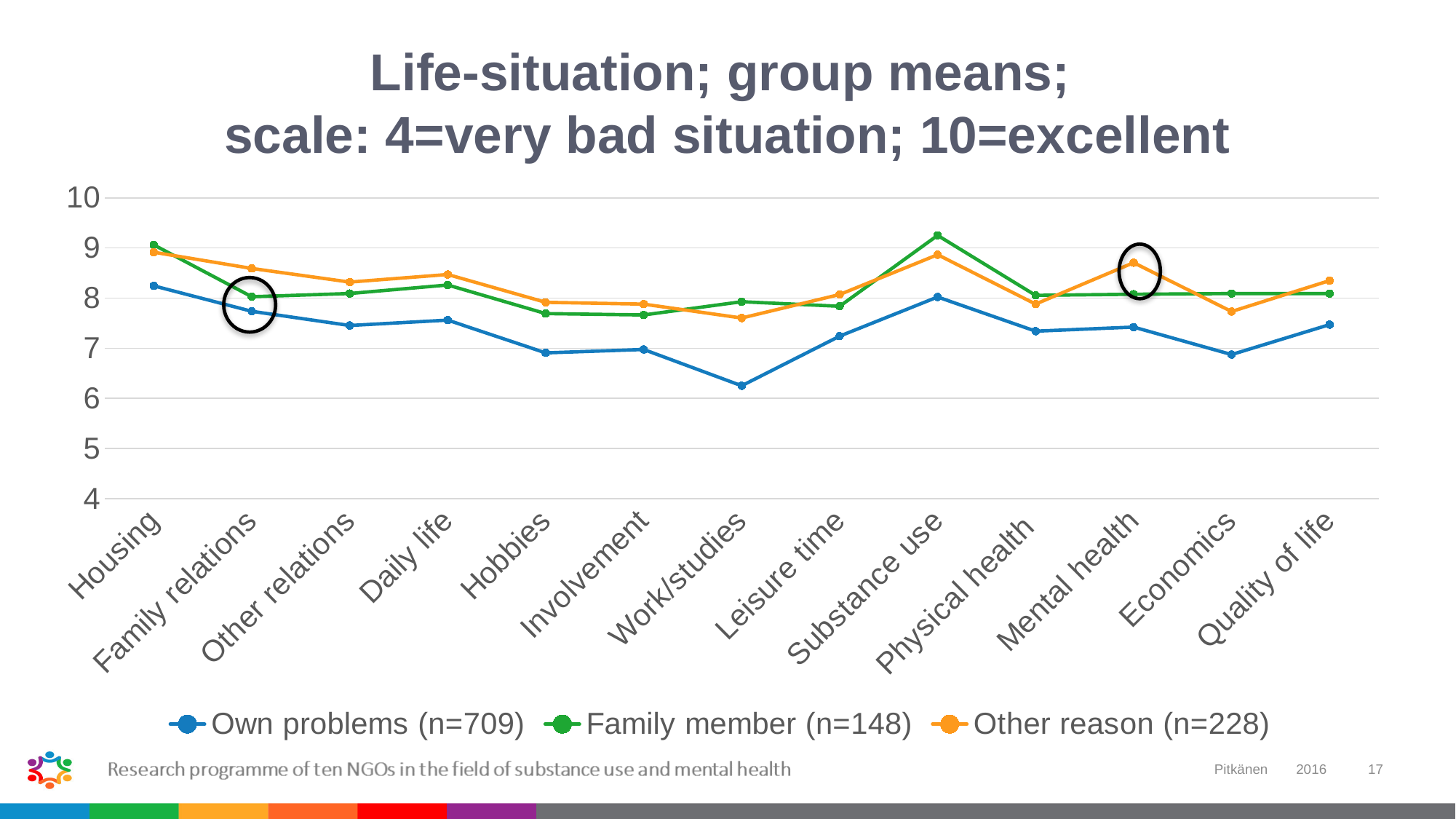
Does the Own problems line rise or fall from Housing to Work/studies? fall At Mental health, which is larger: the Family member value or the Other reason value? Other reason For the Family member series, which category has the highest value? Substance use At Housing, which is larger: the Own problems value or the Other reason value? Other reason How many series does the legend list? 3 According to the legend, what is the sample size (n) for the Own problems group? 709 How many life-situation categories are plotted along the x axis? 13 What kind of chart is shown on the slide? line chart Is the value for Other reason at Family relations greater or less than 8? greater Is the value for Family member at Substance use greater or less than 9? greater Is the value for Own problems at Work/studies greater or less than 7? less For the Own problems series, which category has the lowest value? Work/studies